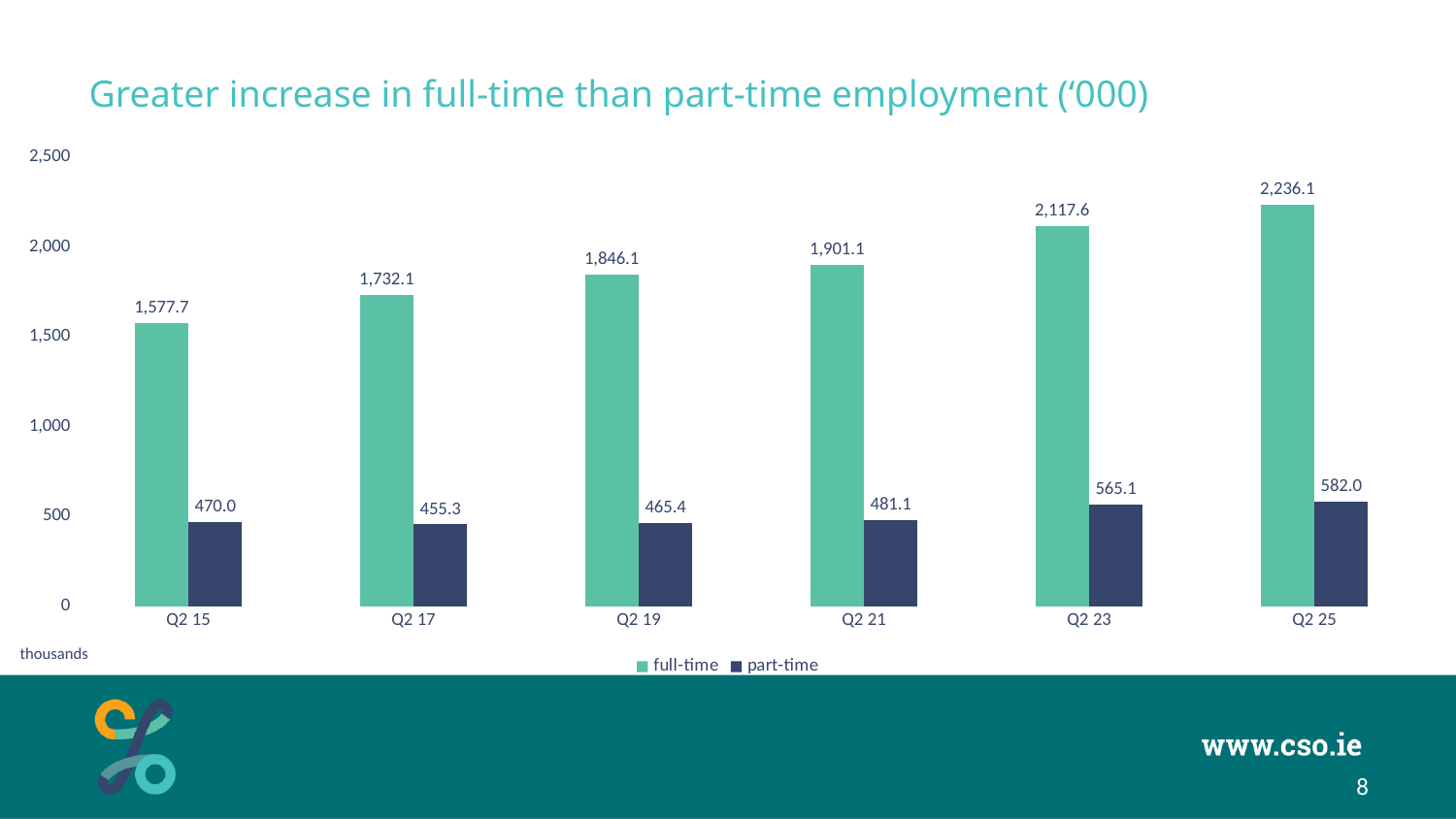
What is the difference between the full-time values for Q2 25 and Q2 15? 658.4 What is the full-time employment value for Q2 19? 1,846.1 Which quarter has the lowest part-time employment value? Q2 17 What is the difference between the part-time values for Q2 23 and Q2 21? 84.0 Which is larger, the part-time value for Q2 15 or for Q2 19? Q2 15 Do the full-time employment values rise or fall from Q2 15 to Q2 25? Rise How many quarters are shown on the x axis? 6 What is the full-time employment value for Q2 25? 2,236.1 What kind of chart is shown on the slide? Bar chart Which quarter has the highest full-time employment value? Q2 25 What is the part-time employment value for Q2 17? 455.3 How many series does the legend list? 2